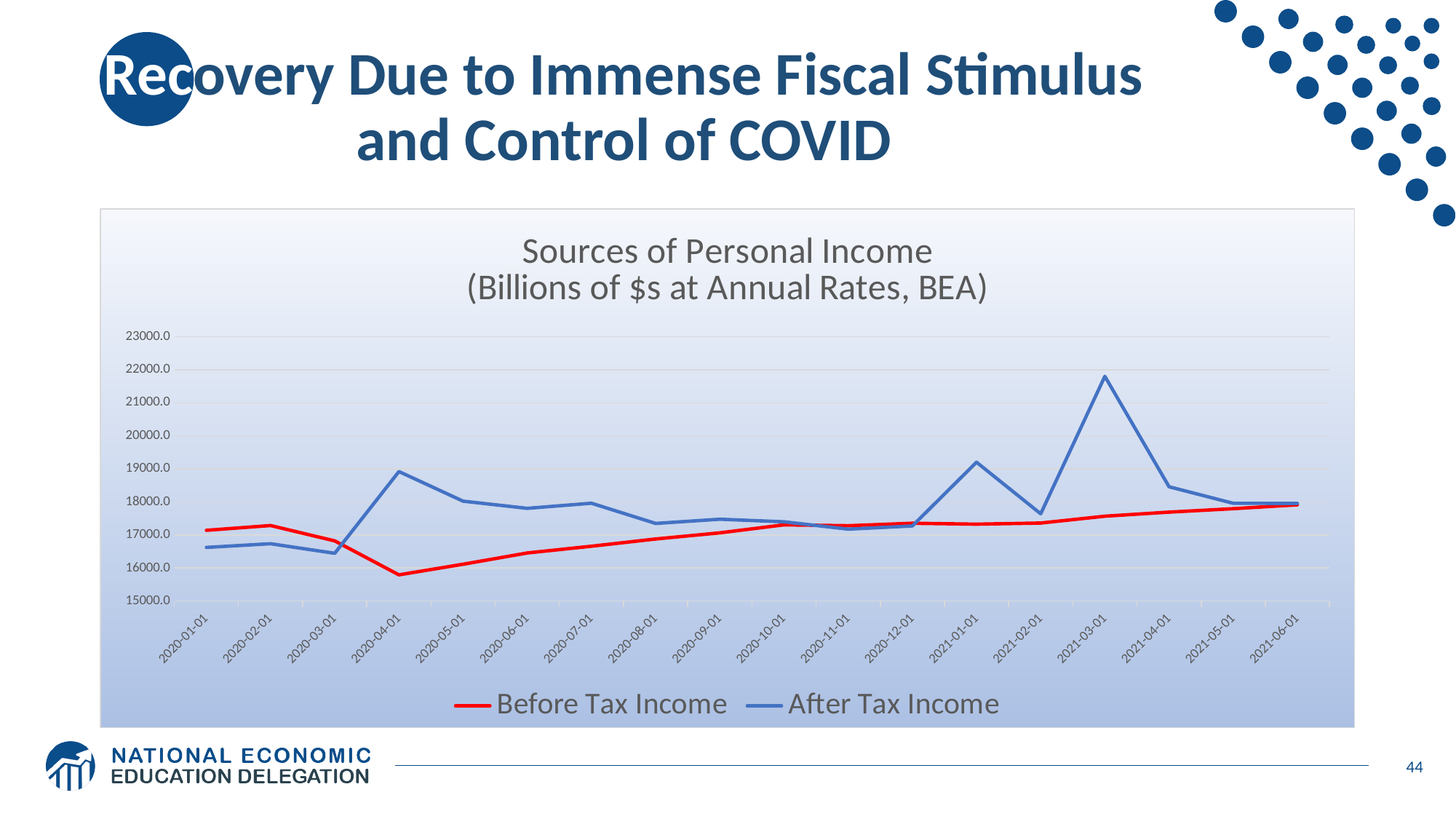
On which date does Before Tax Income reach its lowest value? 2020-04-01 On 2020-01-01, which series has the higher value, Before Tax Income or After Tax Income? Before Tax Income Is the value for After Tax Income on 2021-01-01 greater or less than 18000.0? greater Is the value for Before Tax Income on 2020-04-01 greater or less than 16000.0? less On 2020-04-01, which series has the higher value, Before Tax Income or After Tax Income? After Tax Income How many dates are plotted along the x axis? 18 Is the value for After Tax Income on 2021-03-01 greater or less than 21000.0? greater On which date does After Tax Income reach its highest value? 2021-03-01 What kind of chart is shown on the slide? line chart Does Before Tax Income generally rise or fall from 2020-04-01 to 2021-06-01? rise What colour is the After Tax Income line? blue How many series does the legend list? 2